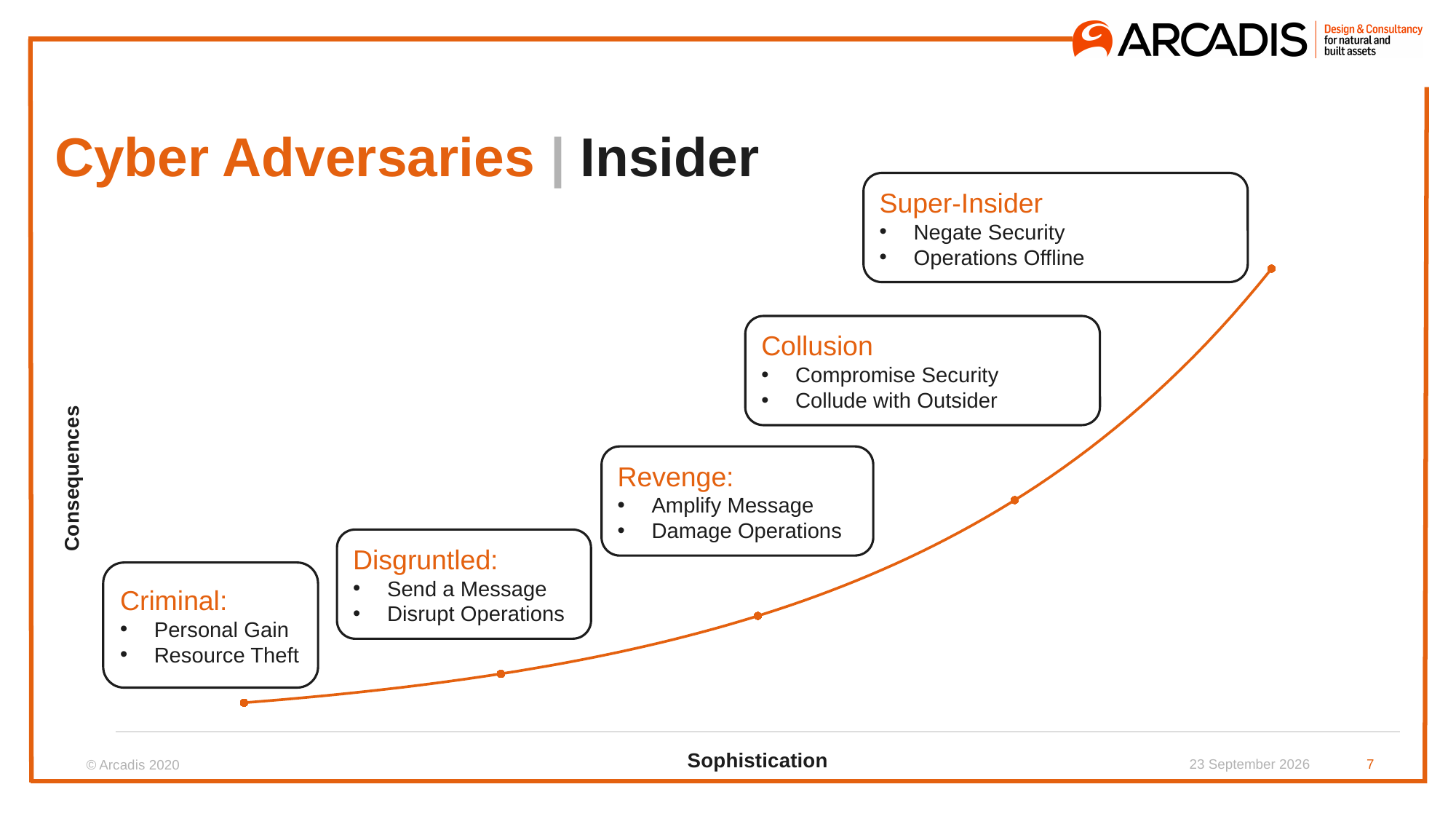
What is the label of the vertical axis? Consequences Do the values on the line rise or fall as sophistication increases along the x axis? Rise Which adversary type is plotted immediately after Revenge along the Sophistication axis? Collusion Which adversary type is plotted at the lowest point on the Consequences axis? Criminal What kind of chart is shown on the slide? Line chart What is the label of the horizontal axis? Sophistication Which has lower sophistication on the chart, Disgruntled or Criminal? Criminal Which adversary type is plotted at the highest point on the Consequences axis? Super-Insider Which has higher consequences on the chart, Collusion or Revenge? Collusion Which adversary type is plotted second from the left on the chart? Disgruntled How many data points are plotted on the line? 5